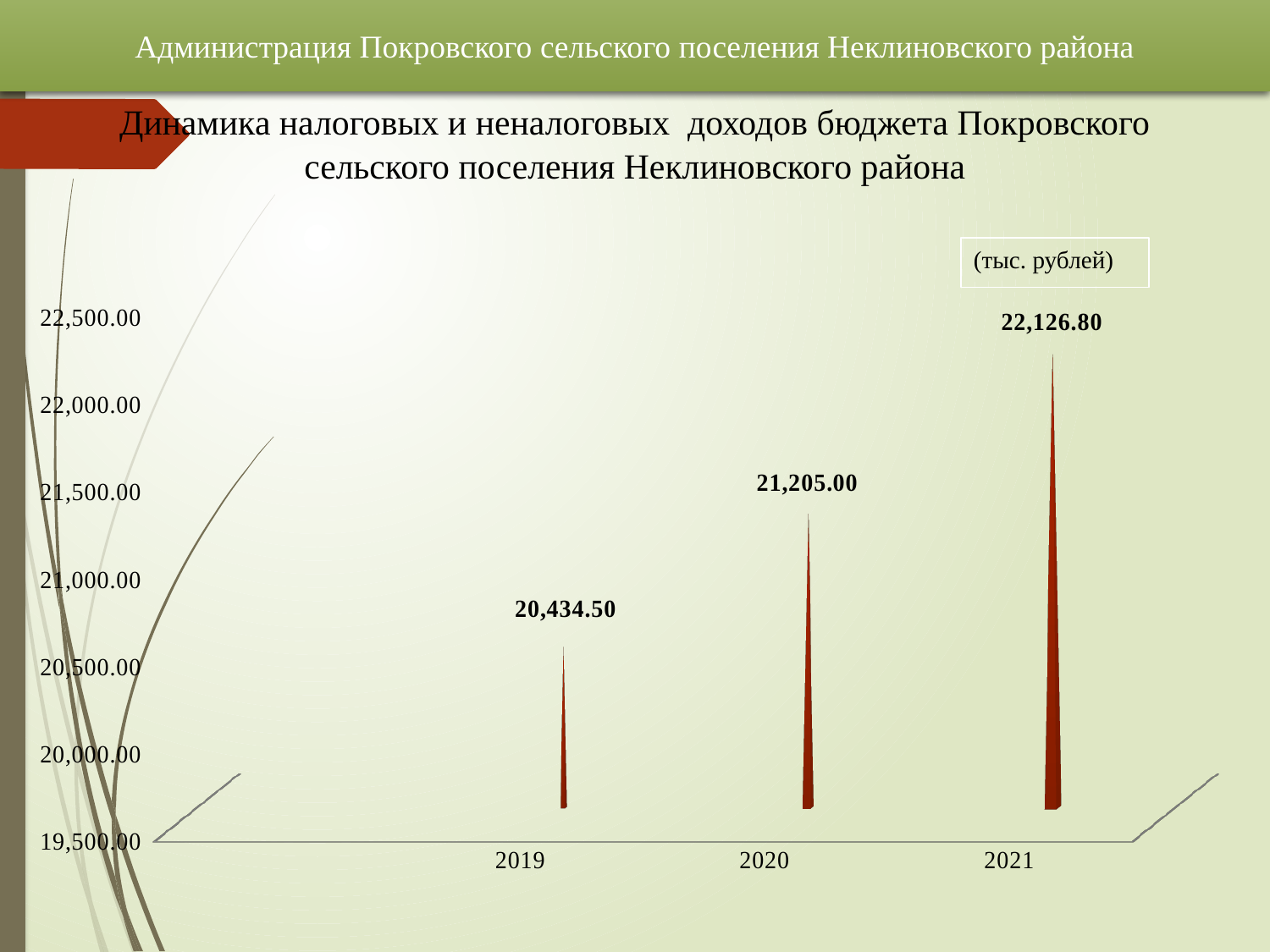
What is the value for 2020? 21,205.00 Do the values rise or fall from 2019 to 2021? rise Which year has the lowest value? 2019 What unit is stated in the box at the top right of the chart? тыс. рублей What is the value for 2021? 22,126.80 What is the difference between the values for 2021 and 2019? 1,692.30 Is the value for 2020 greater or less than 21,000.00? greater How many years are shown on the x axis? 3 What is the value for 2019? 20,434.50 What is the difference between the values for 2020 and 2019? 770.50 Which is larger, the value for 2020 or the value for 2021? 2021 Which year has the highest value? 2021